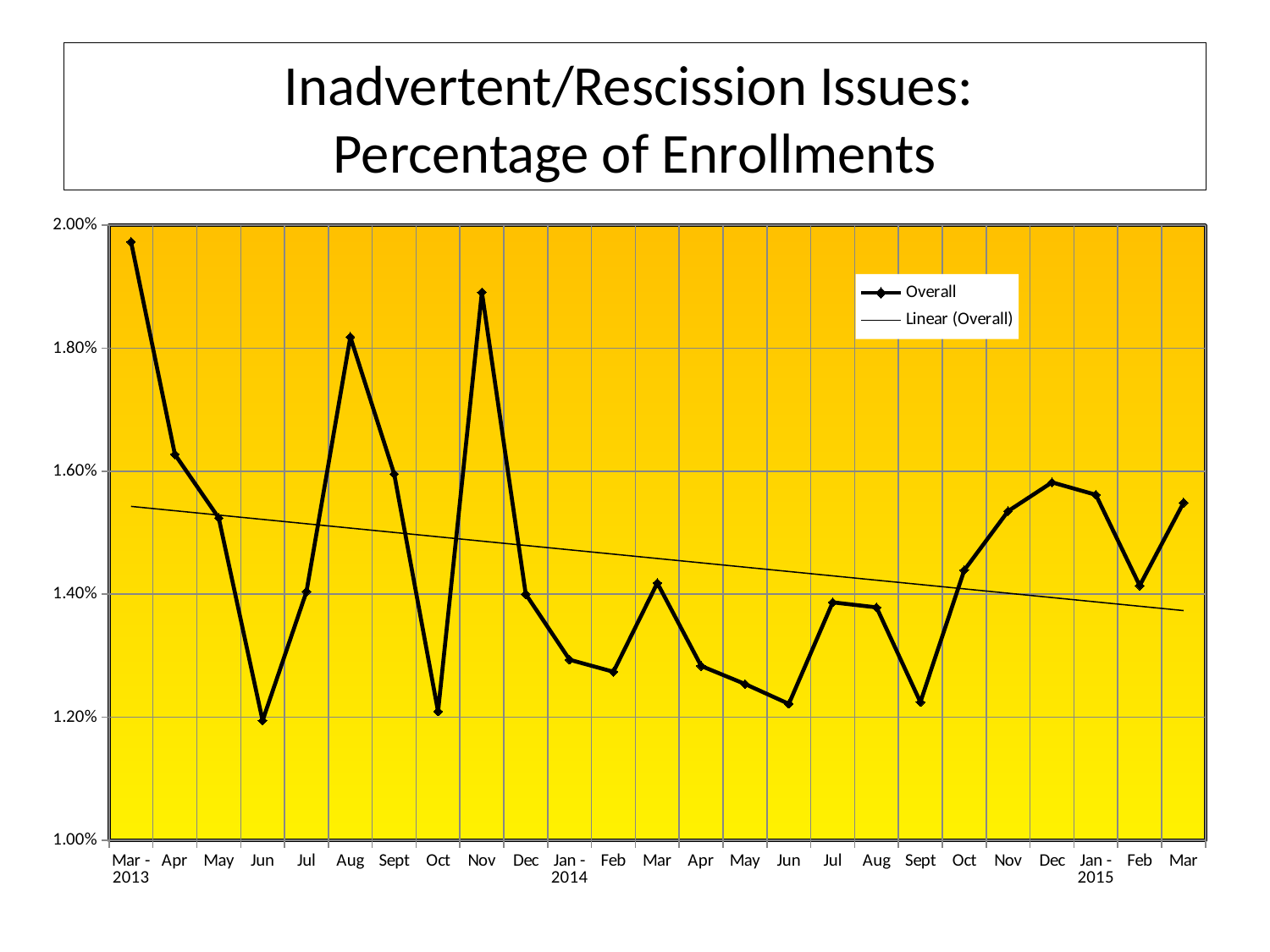
Which month has the highest Overall percentage? Mar 2013 Which is larger, the Overall value for Jun 2014 or for Jul 2014? Jul 2014 What kind of chart is shown on the slide? Line chart Which is larger, the Overall value for Aug 2013 or for Sept 2013? Aug 2013 How many monthly data points are plotted on the Overall line? 25 What are the two entries in the chart legend? Overall and Linear (Overall) Is the Overall value for Sept 2014 greater or less than 1.40%? less Is the Overall value for Dec 2014 greater or less than 1.40%? greater Is the Overall value for Jun 2013 greater or less than 1.40%? less Does the Linear (Overall) trendline rise or fall from left to right? Fall How many series does the legend list? 2